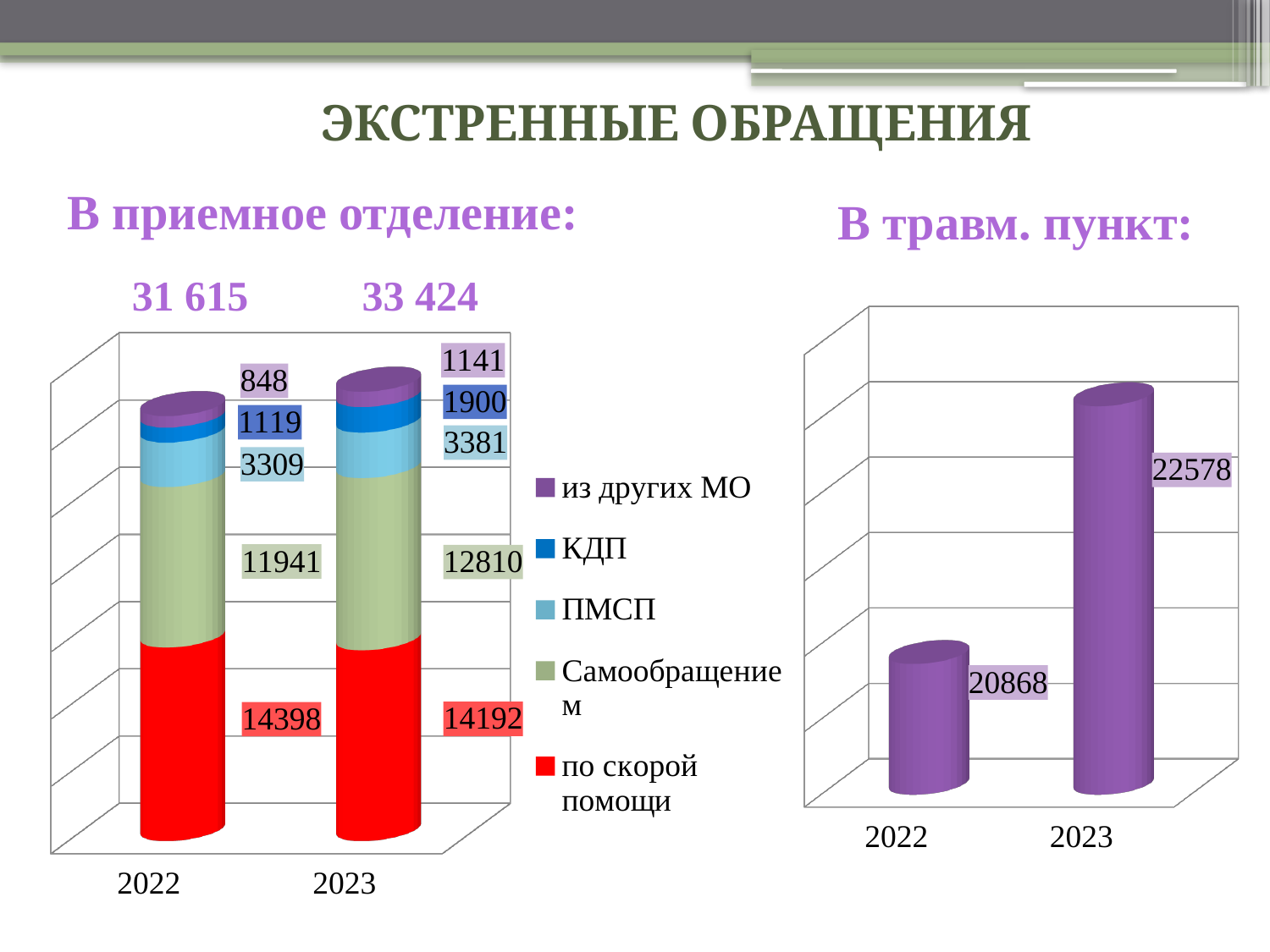
In the chart 'В приемное отделение:', what is the value for 'КДП' in 2023? 1900 In the chart 'В травм. пункт:', which year has the higher value? 2023 In the chart 'В приемное отделение:', how many series does the legend list? 5 What kind of chart is 'В травм. пункт:'? bar chart In the chart 'В травм. пункт:', what is the value for 2023? 22578 In the chart 'В приемное отделение:', what is the value for 'по скорой помощи' in 2022? 14398 In the chart 'В травм. пункт:', what is the difference between the 2023 and 2022 values? 1710 In the chart 'В приемное отделение:', what is the difference between the 'ПМСП' values for 2023 and 2022? 72 In the chart 'В приемное отделение:', what is the value for 'Самообращением' in 2023? 12810 In the chart 'В приемное отделение:', which series has the smallest value in 2022? из других МО In the chart 'В приемное отделение:', what is the total of the stacked bar for 2023? 33 424 In the chart 'В приемное отделение:', what is the value for 'из других МО' in 2022? 848